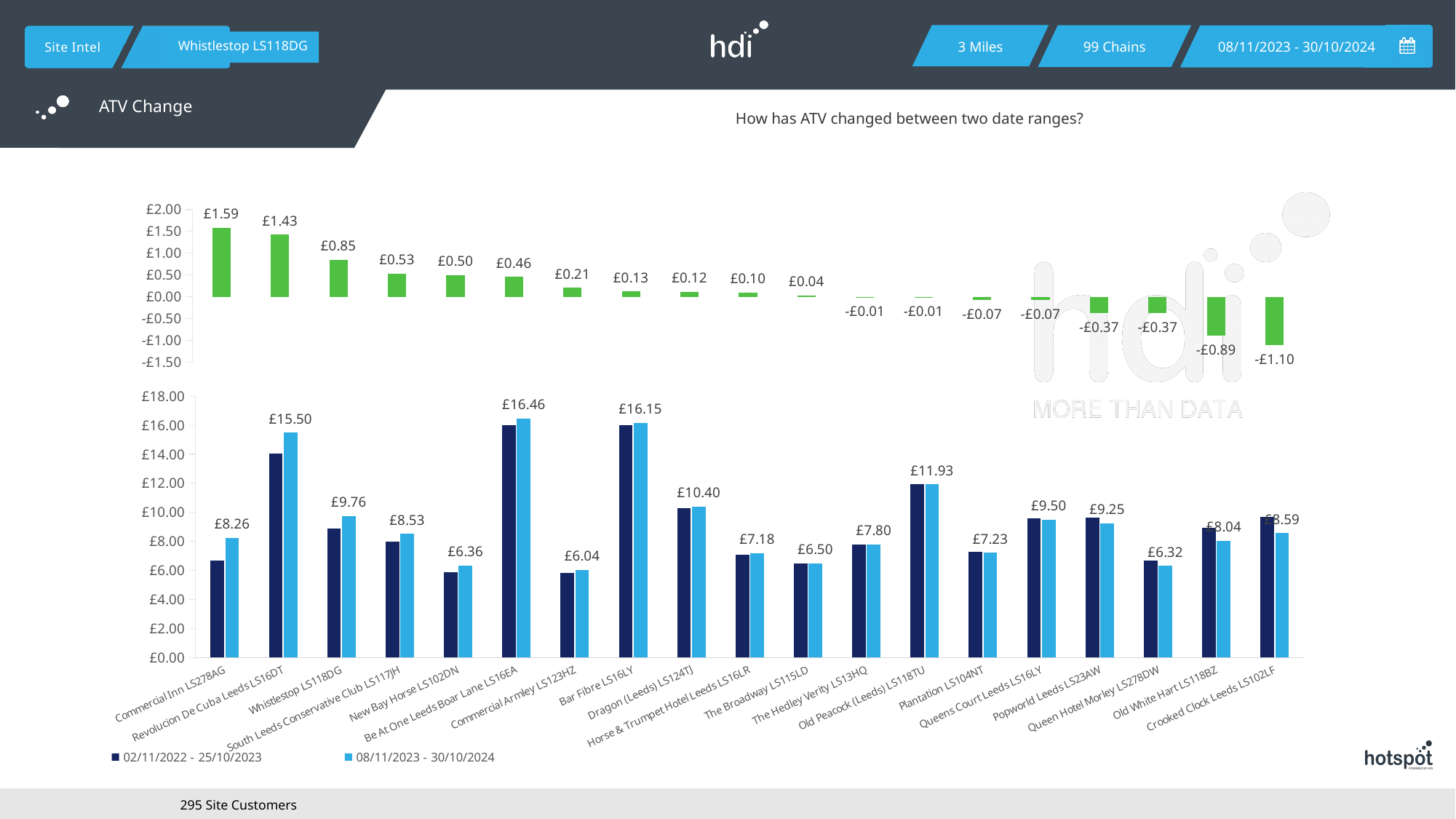
In the top chart (ATV change), which site has the lowest value? Crooked Clock Leeds LS102LF In the bottom chart, how many series does the legend list? 2 What kind of chart is the bottom chart? bar chart In the bottom chart, what is the 08/11/2023 - 30/10/2024 value for Be At One Leeds Boar Lane LS16EA? £16.46 In the bottom chart, which site has the lowest 08/11/2023 - 30/10/2024 value? Commercial Armley LS123HZ In the bottom chart, which has the larger 08/11/2023 - 30/10/2024 value: Old Peacock (Leeds) LS118TU or Dragon (Leeds) LS124TJ? Old Peacock (Leeds) LS118TU In the top chart (ATV change), do the values rise or fall moving from left to right along the x axis? fall In the bottom chart, what is the difference between the 08/11/2023 - 30/10/2024 values for Revolucion De Cuba Leeds LS16DT and Whistlestop LS118DG? £5.74 In the top chart (ATV change), what is the value for Whistlestop LS118DG? £0.85 In the top chart (ATV change), what is the value for Commercial Inn LS278AG? £1.59 In the bottom chart, is the 02/11/2022 - 25/10/2023 value for Commercial Inn LS278AG greater or less than £8.00? less In the top chart (ATV change), which site has the highest value? Commercial Inn LS278AG